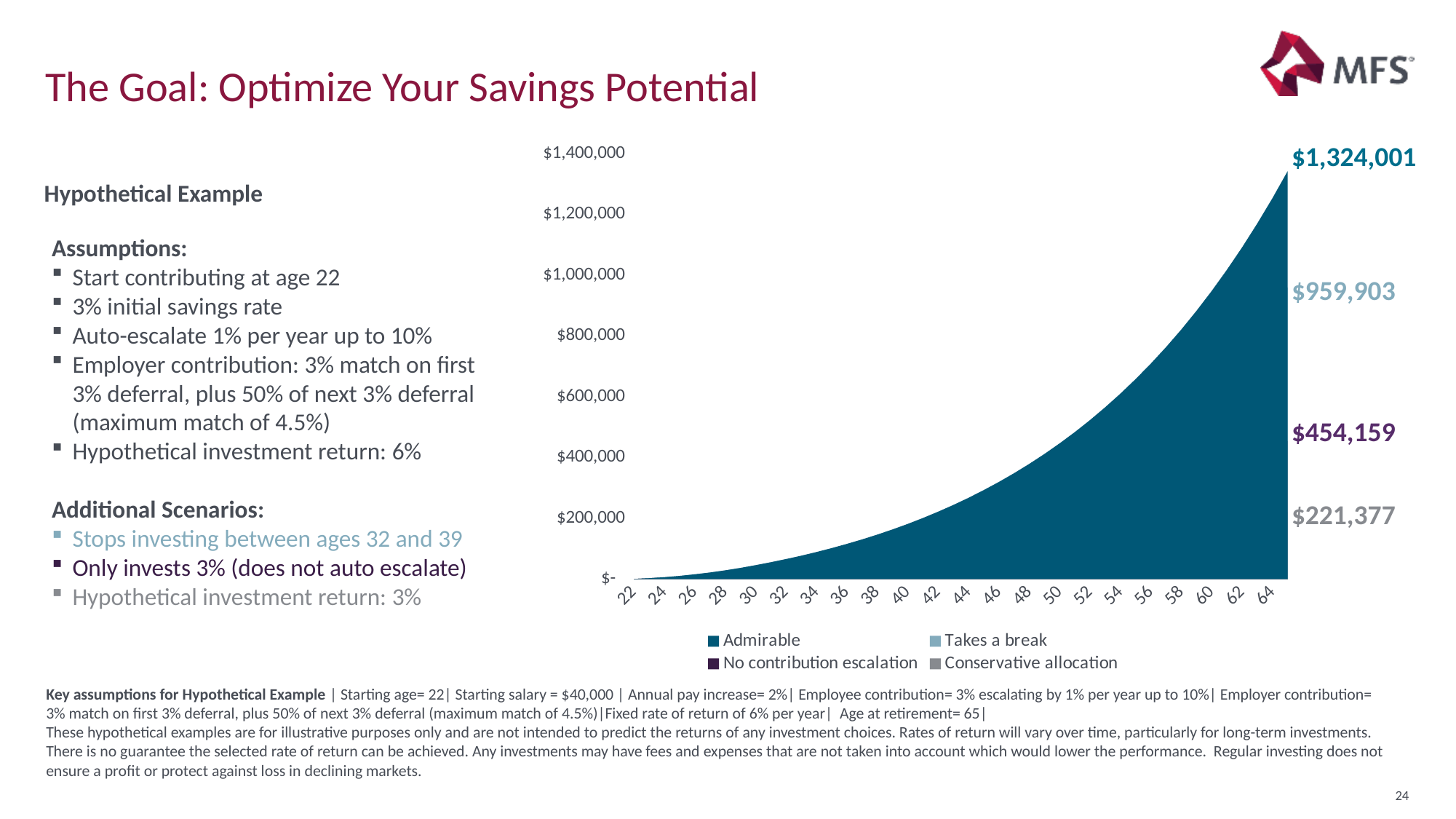
What is the final value shown for the Takes a break scenario? $959,903 What is the difference between the final values of the No contribution escalation and Conservative allocation scenarios? $232,782 How many series does the legend list? 4 What is the final value shown for the No contribution escalation scenario? $454,159 What is the final value shown for the Conservative allocation scenario? $221,377 Which scenario has the highest final value on the chart? Admirable Does the Admirable series rise or fall as age increases along the x axis? Rises What is the final value shown for the Admirable scenario at the end of the chart? $1,324,001 What kind of chart is shown on the slide? Area chart Which scenario has the lowest final value on the chart? Conservative allocation Which final value is larger: Takes a break or No contribution escalation? Takes a break What is the difference between the final values of the Admirable and Takes a break scenarios? $364,098